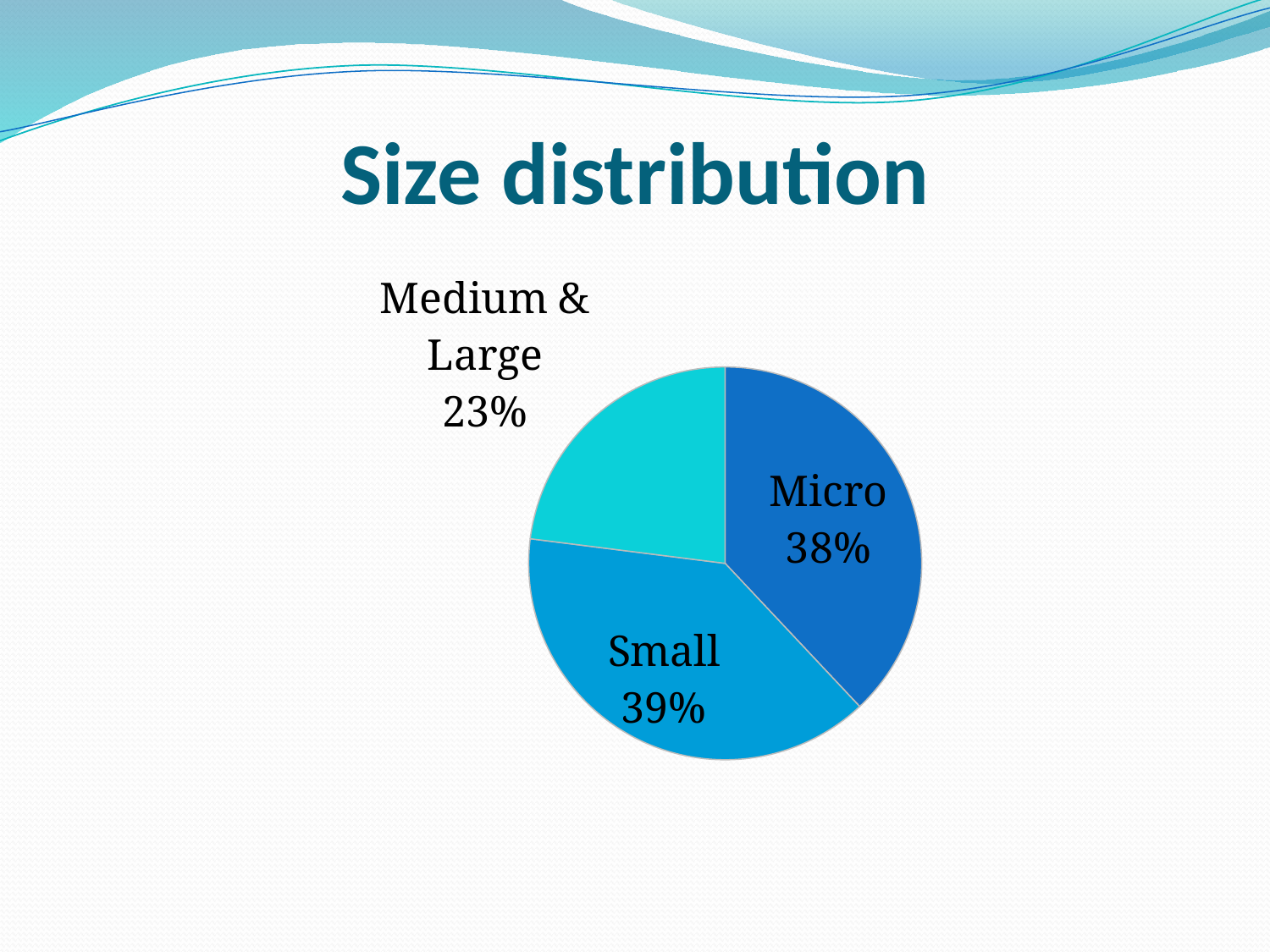
What is the title of the slide? Size distribution What is the difference in percentage points between the Micro and Medium & Large shares? 15 What kind of chart is shown on the slide? Pie chart How many slices does the pie chart have? 3 Which category has the smallest share of the pie? Medium & Large What share of the pie does the Micro slice represent? 38% What is the combined share of the Micro and Small slices? 77% What is the difference in percentage points between the Small and Medium & Large shares? 16 What share of the pie does the Medium & Large slice represent? 23% What share of the pie does the Small slice represent? 39% Which is larger, the Micro share or the Medium & Large share? Micro